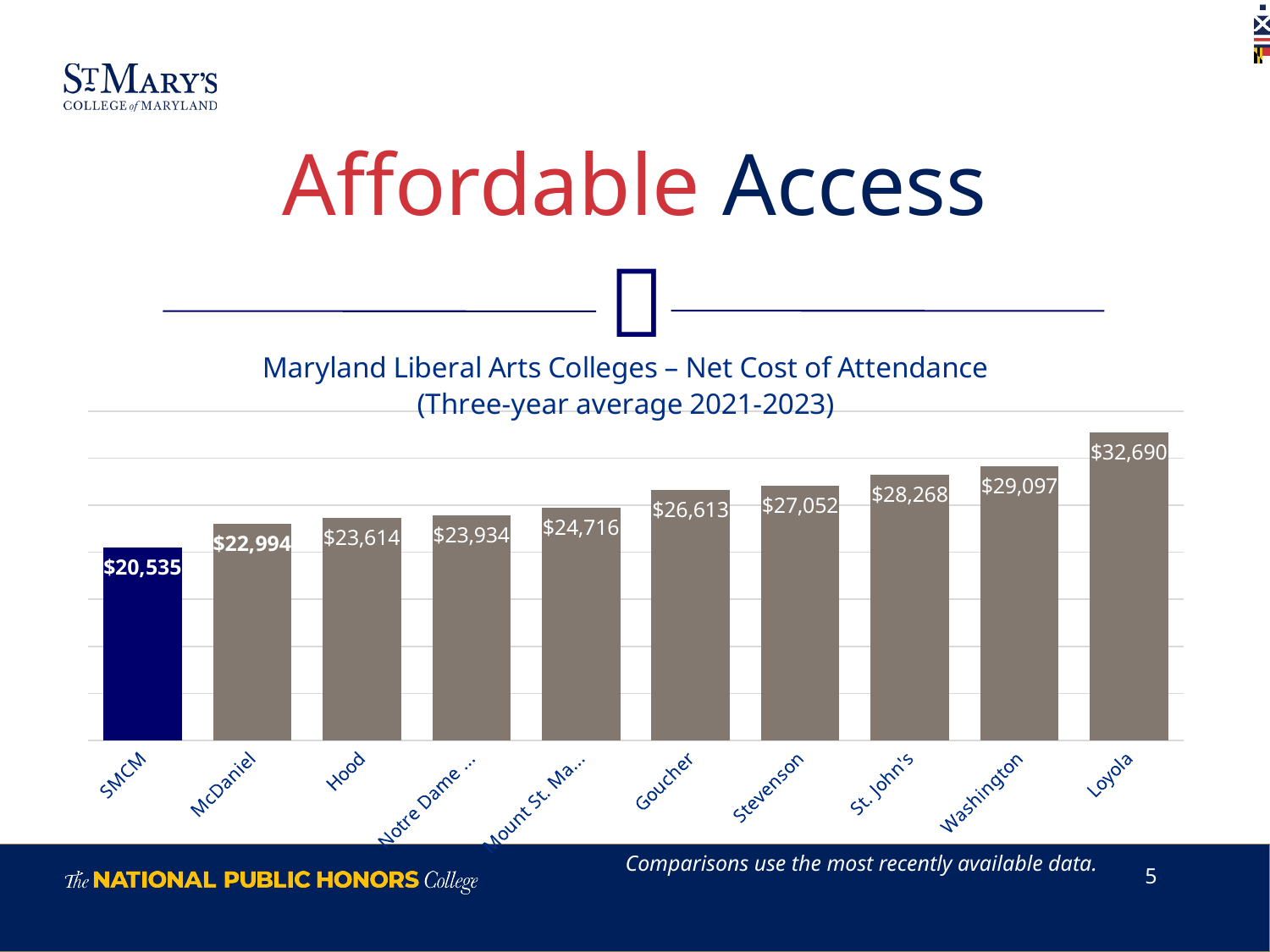
What is the difference between Washington's and Goucher's net cost of attendance? $2,484 Which college has the highest net cost of attendance on the chart? Loyola What kind of chart is shown on the slide? Bar chart Which has a higher net cost of attendance, Hood or Stevenson? Stevenson How many colleges are shown on the chart? 10 What is the difference between Loyola's and SMCM's net cost of attendance? $12,155 What is the net cost of attendance shown for St. John's? $28,268 What is the net cost of attendance shown for Washington? $29,097 What is the net cost of attendance shown for Goucher? $26,613 Which college has the lowest net cost of attendance on the chart? SMCM What is the title of the chart? Maryland Liberal Arts Colleges – Net Cost of Attendance (Three-year average 2021-2023) What is the net cost of attendance shown for SMCM? $20,535